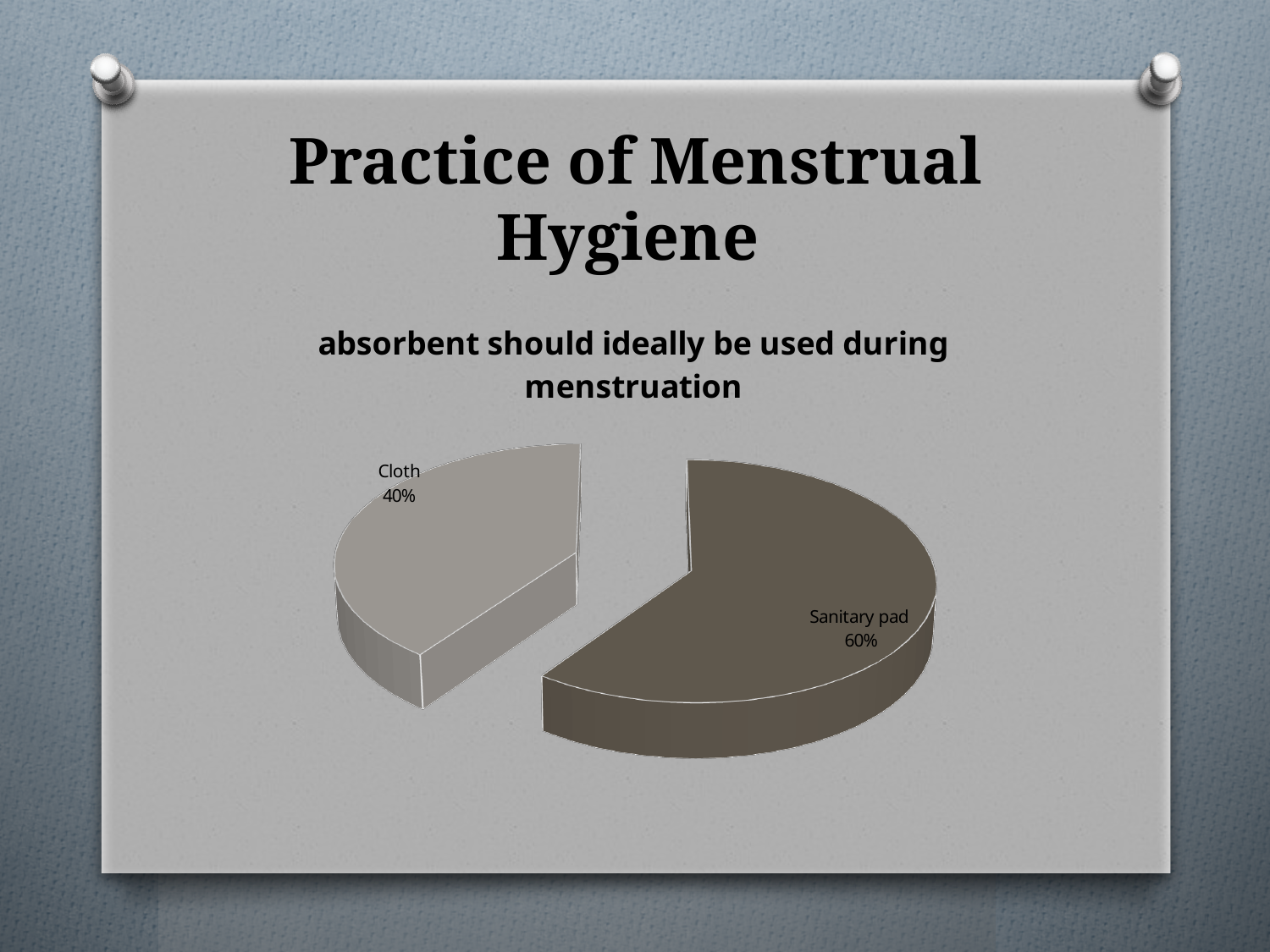
What share of the pie does Sanitary pad represent? 60% What share of the pie does Cloth represent? 40% What kind of chart is shown on the slide? Pie chart Which is larger, the share for Cloth or the share for Sanitary pad? Sanitary pad Which category has the smallest slice of the pie? Cloth What is the chart's title? absorbent should ideally be used during menstruation What is the difference in percentage points between Sanitary pad and Cloth? 20% How many slices does the pie chart have? 2 Which slice is shown in the darker colour? Sanitary pad Which category has the largest slice of the pie? Sanitary pad Is the share for Cloth greater or less than 50%? less